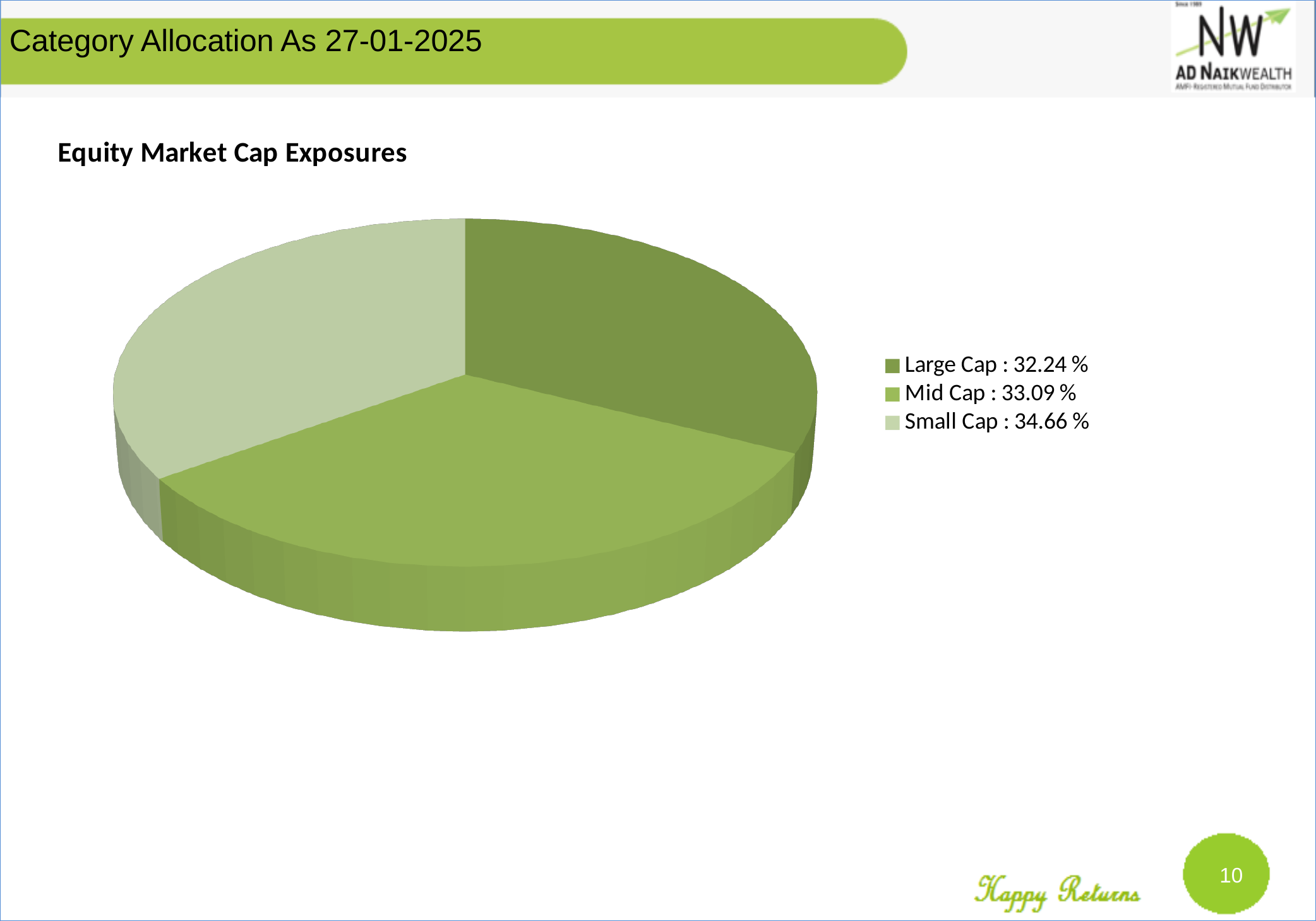
Which category is shown in the lightest green colour? Small Cap How many categories does the pie chart show? 3 Which category has the highest value? Small Cap What is the title of the chart? Equity Market Cap Exposures What is the difference between the Small Cap and Large Cap values? 2.42 % Which category has the lowest value? Large Cap What is the difference between the Mid Cap and Large Cap values? 0.85 % What kind of chart is shown on the slide? Pie chart What is the value for Large Cap? 32.24 % Which is larger, Mid Cap or Small Cap? Small Cap What is the value for Small Cap? 34.66 % What is the value for Mid Cap? 33.09 %